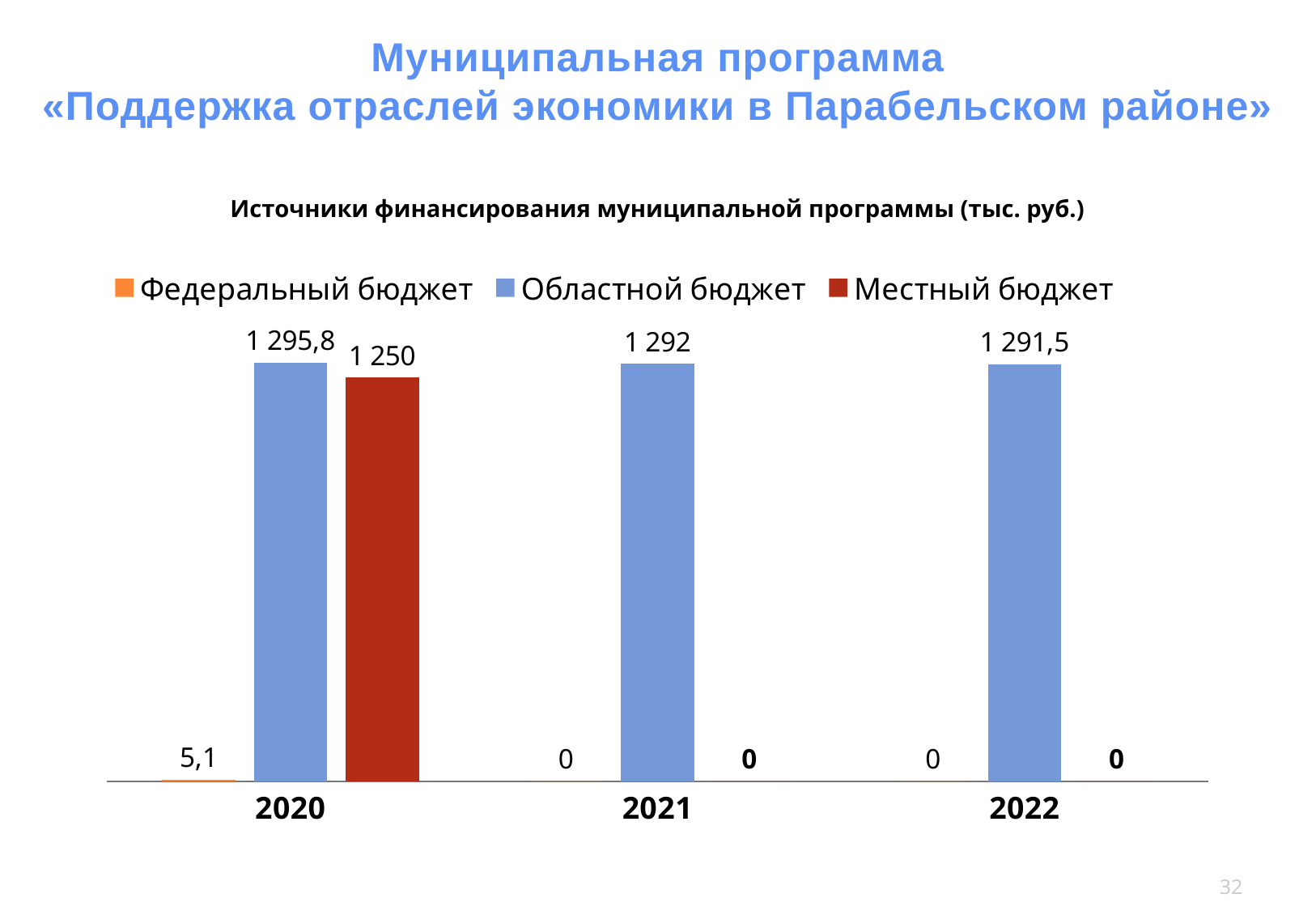
What is the value for Федеральный бюджет in 2020? 5,1 In which year is the value for Областной бюджет highest? 2020 Do the values for Областной бюджет rise or fall from 2020 to 2022? fall Which is larger in 2020: Областной бюджет or Местный бюджет? Областной бюджет What is the value for Областной бюджет in 2020? 1 295,8 What is the value for Местный бюджет in 2020? 1 250 What is the value for Местный бюджет in 2021? 0 What is the difference between Областной бюджет and Местный бюджет in 2020? 45,8 What is the difference between the Областной бюджет values for 2020 and 2021? 3,8 What is the value for Областной бюджет in 2022? 1 291,5 How many years are shown on the x axis? 3 How many series does the legend list? 3